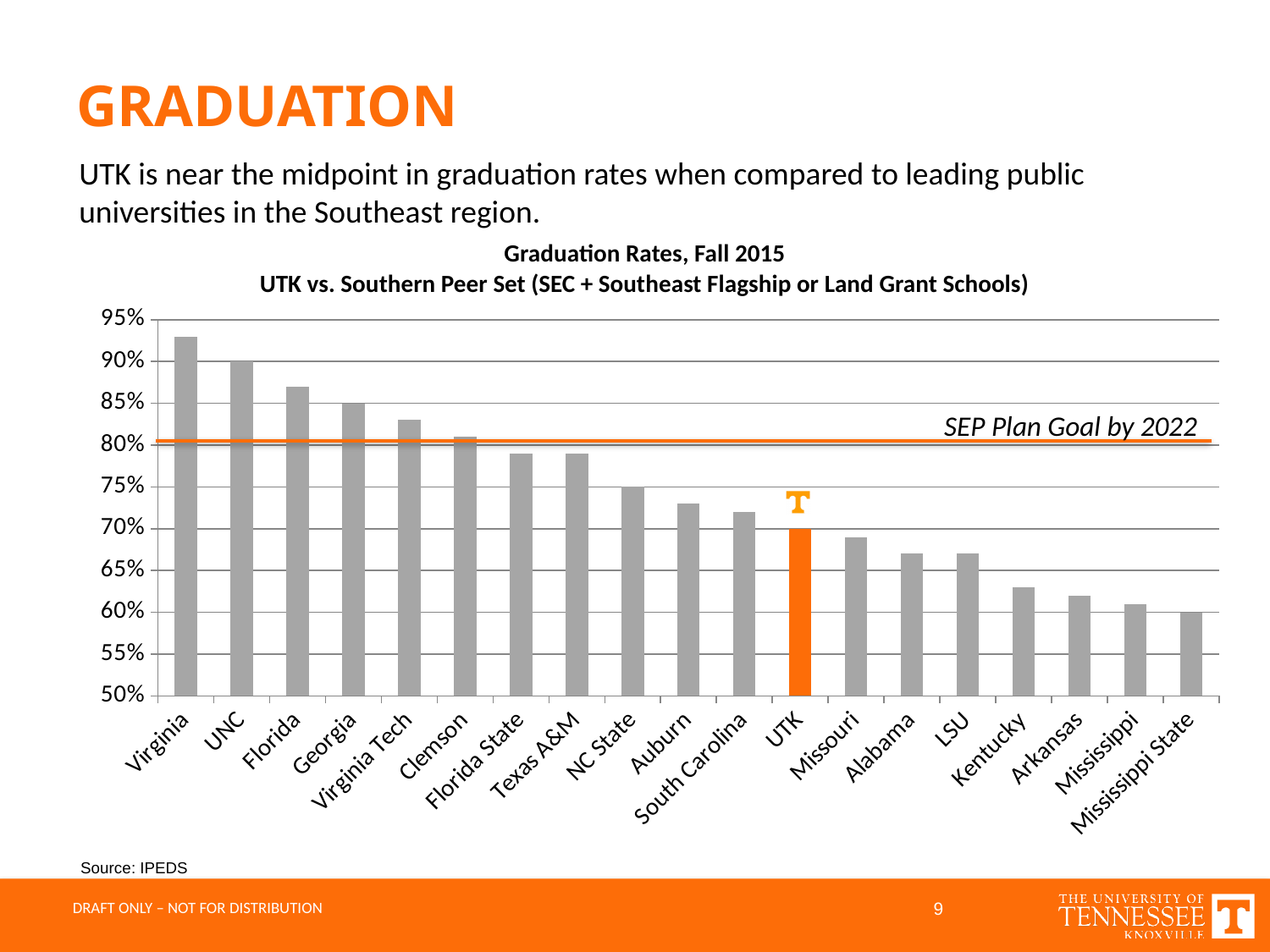
Is the graduation rate for Auburn greater or less than 75%? less Which school has the lowest graduation rate in the chart? Mississippi State Is the graduation rate for Clemson greater or less than 80%? greater Which school has the highest graduation rate in the chart? Virginia Is the graduation rate for Kentucky greater or less than 65%? less Which has a higher graduation rate, Florida or Missouri? Florida What does the horizontal orange line across the chart represent? SEP Plan Goal by 2022 What is the graduation rate shown for UTK? 70% What kind of chart is shown on the slide? bar chart Do the graduation rates rise or fall moving from left to right across the chart? fall How many schools are shown in the chart? 19